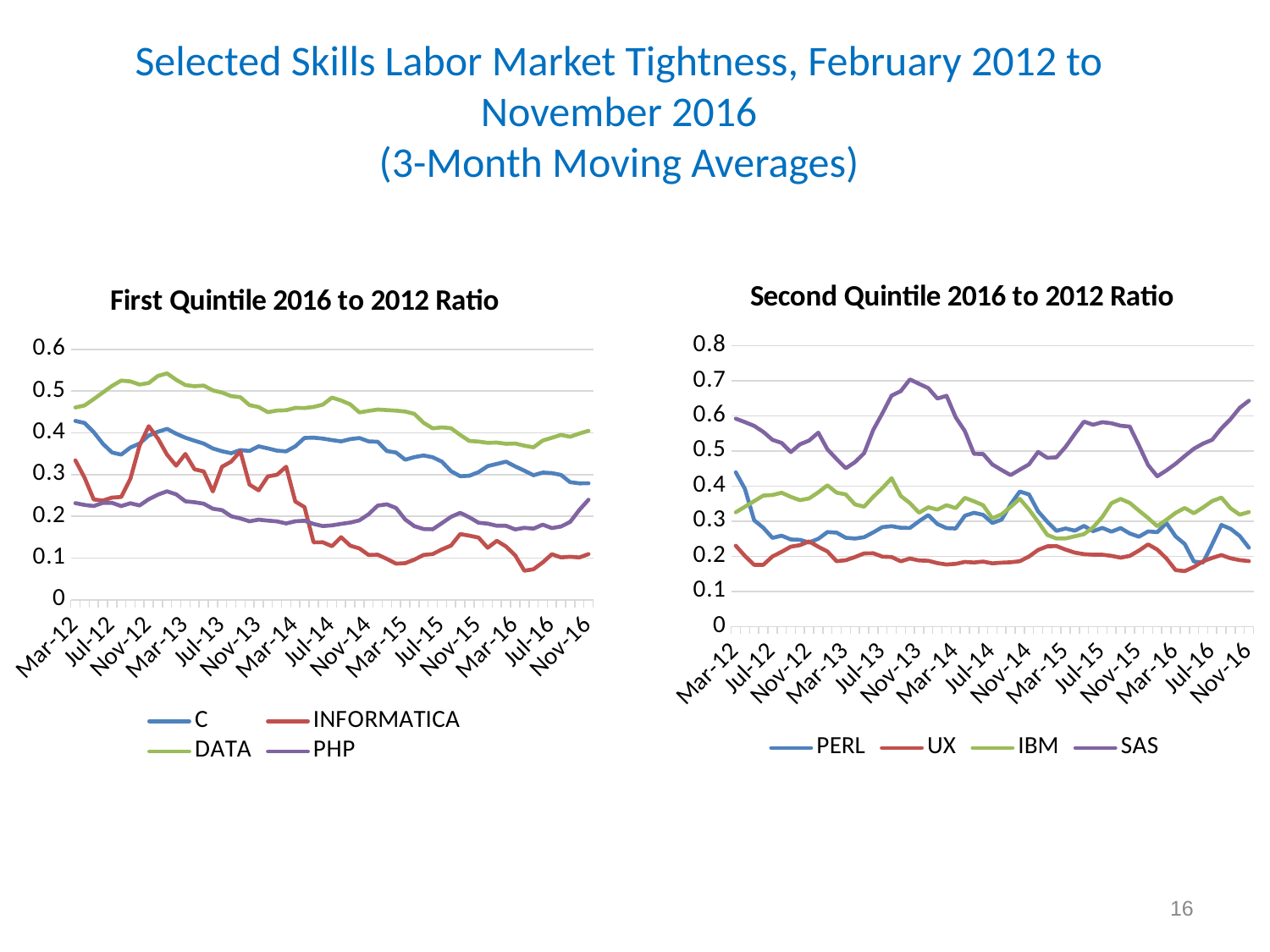
Which series are listed in the legend of the "First Quintile 2016 to 2012 Ratio" chart? C, INFORMATICA, DATA, PHP What kind of chart is the "First Quintile 2016 to 2012 Ratio" chart? line chart In the "First Quintile 2016 to 2012 Ratio" chart, which series has the highest value at Nov-16? DATA How many series does the legend of the "Second Quintile 2016 to 2012 Ratio" chart list? 4 In the "First Quintile 2016 to 2012 Ratio" chart, is the value for DATA at Mar-12 greater or less than 0.4? greater In the "First Quintile 2016 to 2012 Ratio" chart, does the INFORMATICA series generally rise or fall from Mar-12 to Nov-16? fall In the "Second Quintile 2016 to 2012 Ratio" chart, which is larger at Nov-16, SAS or UX? SAS In the "Second Quintile 2016 to 2012 Ratio" chart, which series has the highest value at Nov-16? SAS In the "Second Quintile 2016 to 2012 Ratio" chart, is the value for SAS at Nov-13 greater or less than 0.6? greater In the "First Quintile 2016 to 2012 Ratio" chart, which series has the lowest value at Nov-16? INFORMATICA In the "Second Quintile 2016 to 2012 Ratio" chart, is the value for UX at Nov-16 greater or less than 0.3? less